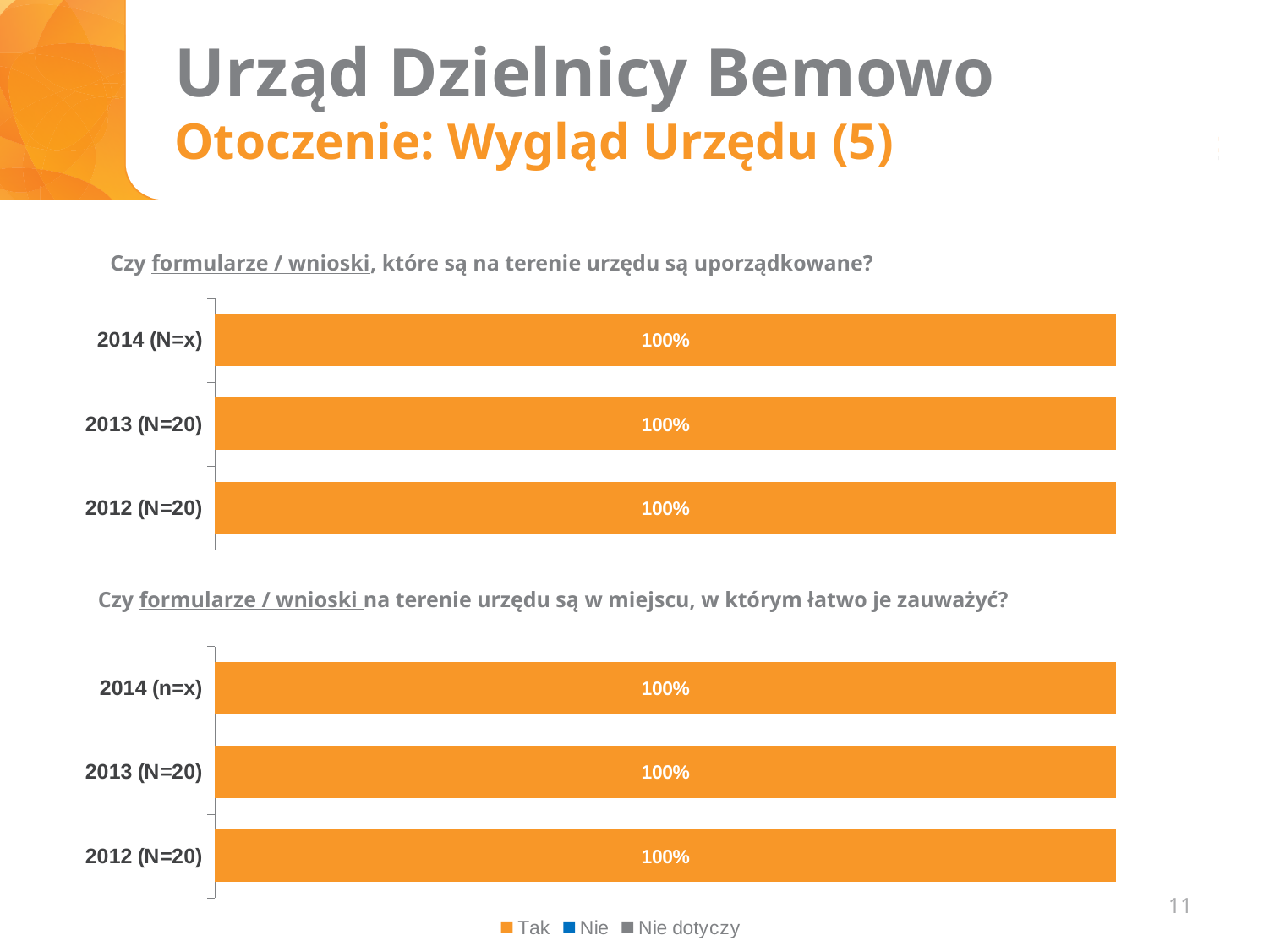
In the bottom chart, what is the difference between the values for 2013 (N=20) and 2012 (N=20)? 0% In the bottom chart ("Czy formularze / wnioski na terenie urzędu są w miejscu, w którym łatwo je zauważyć?"), what is the value for 2012 (N=20)? 100% How many categories (years) are shown in the bottom chart? 3 In the bottom chart ("Czy formularze / wnioski na terenie urzędu są w miejscu, w którym łatwo je zauważyć?"), what is the value for 2014 (n=x)? 100% How many categories (years) are shown in the top chart? 3 What kind of chart is the top chart? Bar chart In the bottom chart, do the values change from 2012 (N=20) to 2014 (n=x)? No, they stay at 100% In the top chart, what is the difference between the values for 2014 (N=x) and 2012 (N=20)? 0% How many series does the legend at the bottom of the slide list? 3 In the top chart ("Czy formularze / wnioski, które są na terenie urzędu są uporządkowane?"), what is the value for 2012 (N=20)? 100% Which series in the legend is shown in orange? Tak In the top chart ("Czy formularze / wnioski, które są na terenie urzędu są uporządkowane?"), what is the value for 2013 (N=20)? 100%